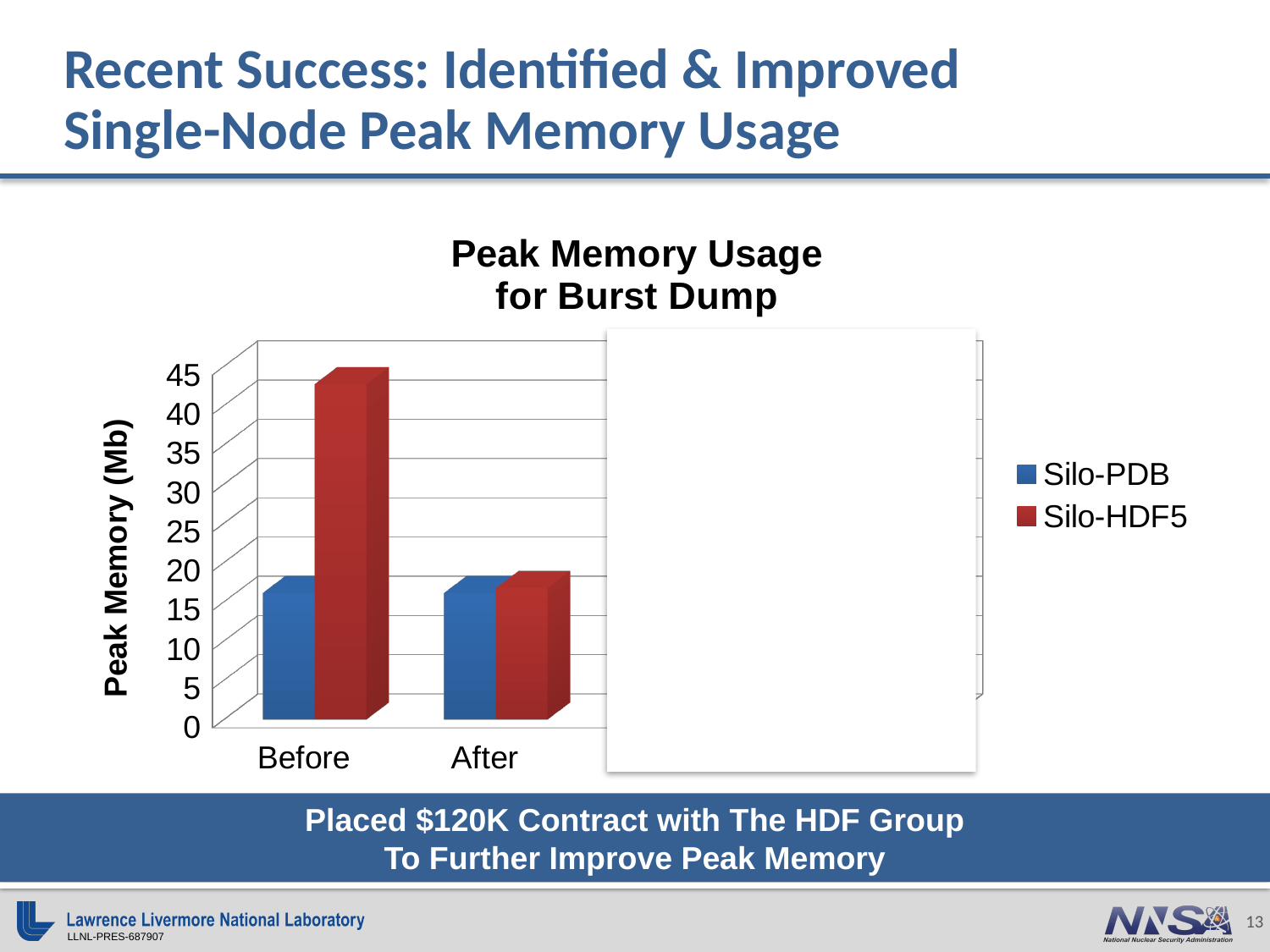
What is the title of the chart? Peak Memory Usage for Burst Dump How many categories are shown on the x axis of the chart? 2 What type of chart is shown on the slide? bar chart Is the Silo-HDF5 value for Before greater or less than 35? greater For the Before category, which is larger: Silo-PDB or Silo-HDF5? Silo-HDF5 What is the label of the y axis? Peak Memory (Mb) How many series does the chart legend list? 2 Is the Silo-HDF5 value for After greater or less than 20? less Which series are listed in the chart legend? Silo-PDB and Silo-HDF5 Is the Silo-PDB value for Before greater or less than 20? less Does the Silo-HDF5 value rise or fall from Before to After? fall Which bar is the highest in the chart? Silo-HDF5 for Before